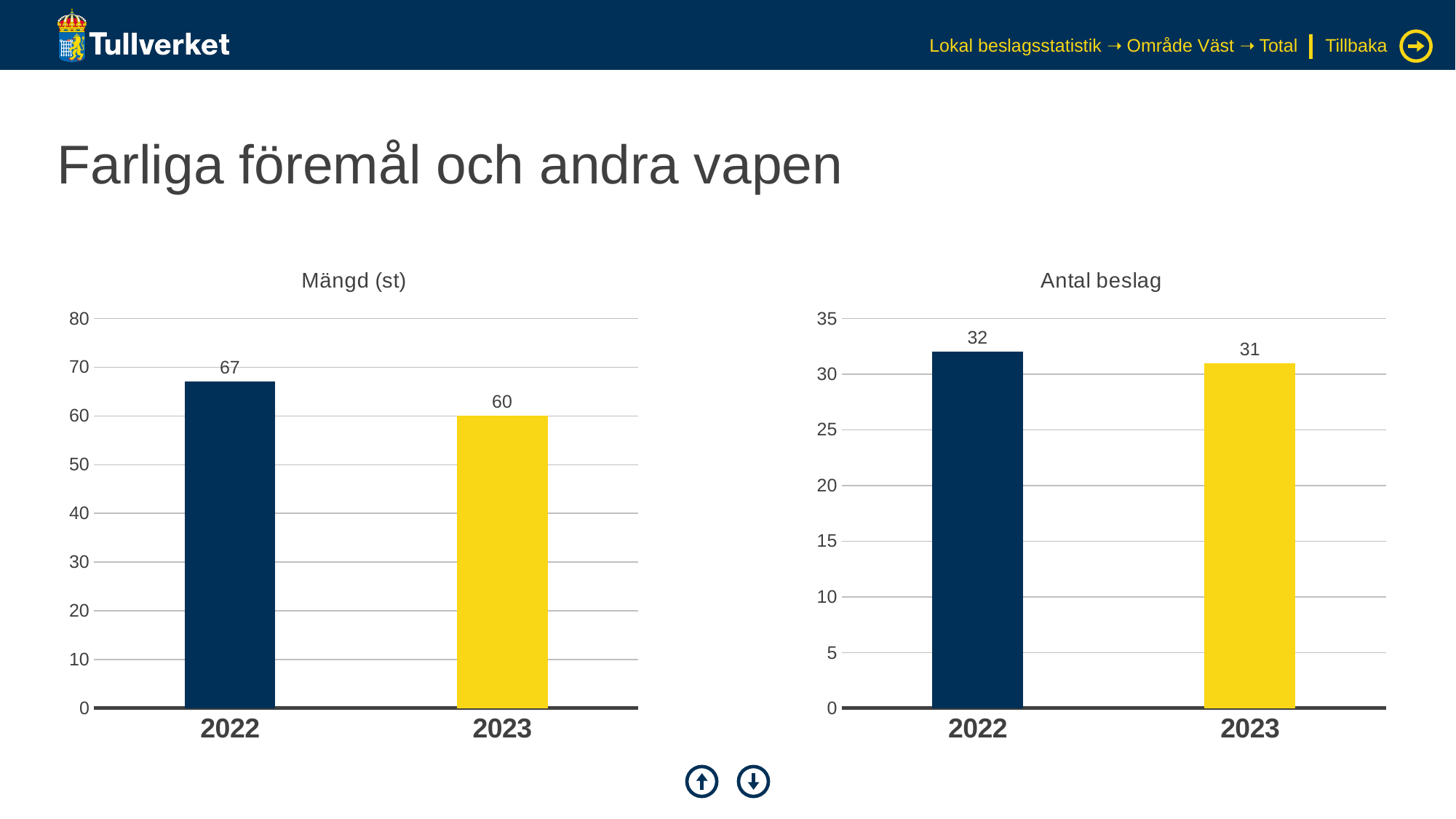
In the 'Antal beslag' chart, do the values rise or fall from 2022 to 2023? fall In the 'Antal beslag' chart, what is the value for 2023? 31 In the 'Mängd (st)' chart, what is the difference between the 2022 and 2023 values? 7 In the 'Antal beslag' chart, what is the difference between the 2022 and 2023 values? 1 In the 'Mängd (st)' chart, which year has the highest value? 2022 In the 'Mängd (st)' chart, what is the value for 2022? 67 In the 'Mängd (st)' chart, is the value for 2023 greater or less than 50? greater In the 'Mängd (st)' chart, what is the value for 2023? 60 In the 'Antal beslag' chart, what is the value for 2022? 32 What kind of chart is the 'Mängd (st)' chart? bar chart In the 'Antal beslag' chart, which year has the lowest value? 2023 How many categories are shown on the x axis of the 'Antal beslag' chart? 2